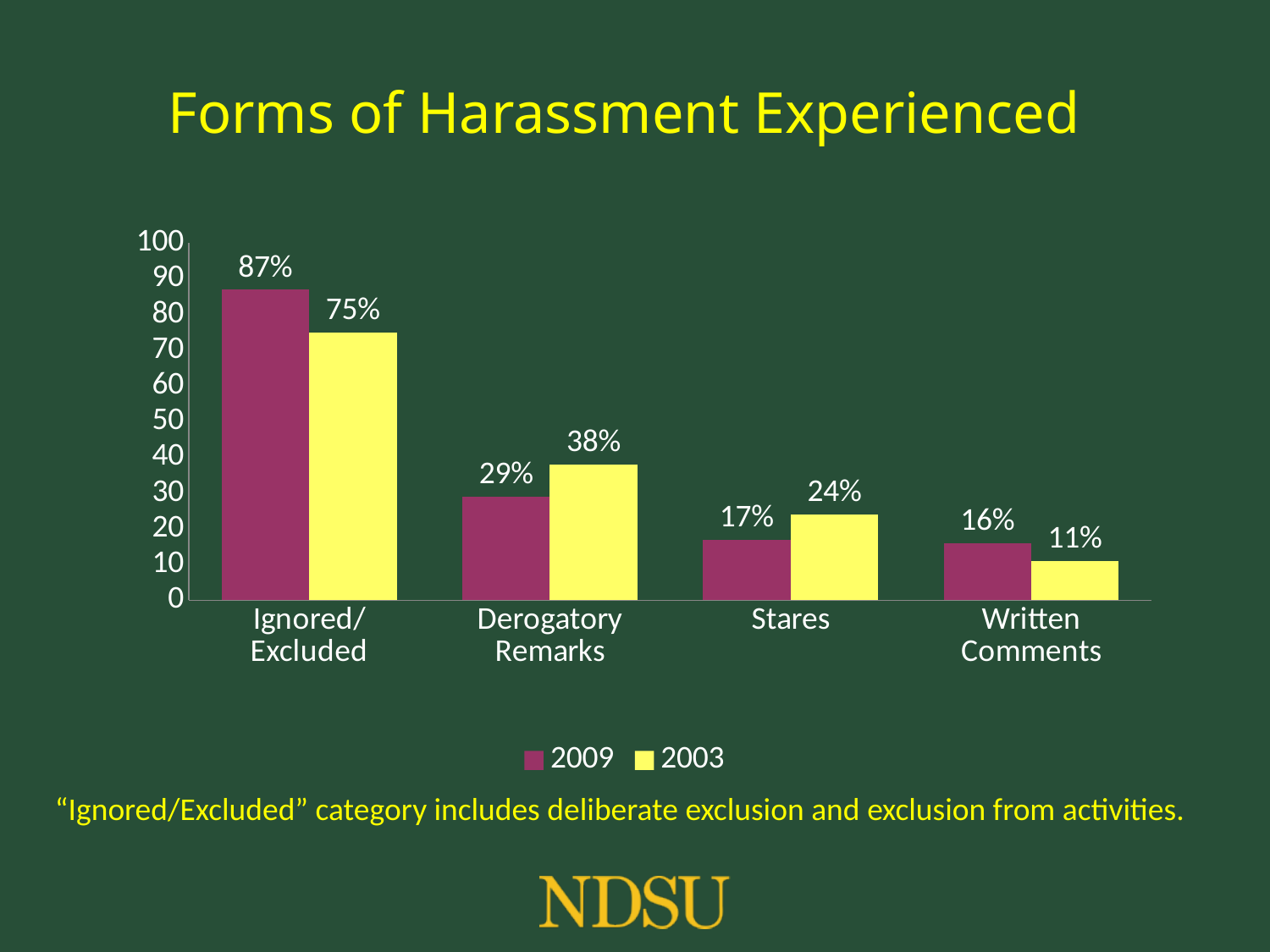
How many series does the legend list? 2 Which is larger for Derogatory Remarks, the 2009 value or the 2003 value? 2003 How many categories are shown on the x axis? 4 Which category has the lowest 2003 value? Written Comments What is the 2003 value for Written Comments? 11% What is the 2003 value for Derogatory Remarks? 38% Which category has the highest 2009 value? Ignored/Excluded What kind of chart is shown on the slide? bar chart What is the difference between the 2003 and 2009 values for Stares? 7% What is the 2009 value for Ignored/Excluded? 87% Is the 2003 value for Stares greater or less than 20? greater What is the difference between the 2009 and 2003 values for Ignored/Excluded? 12%